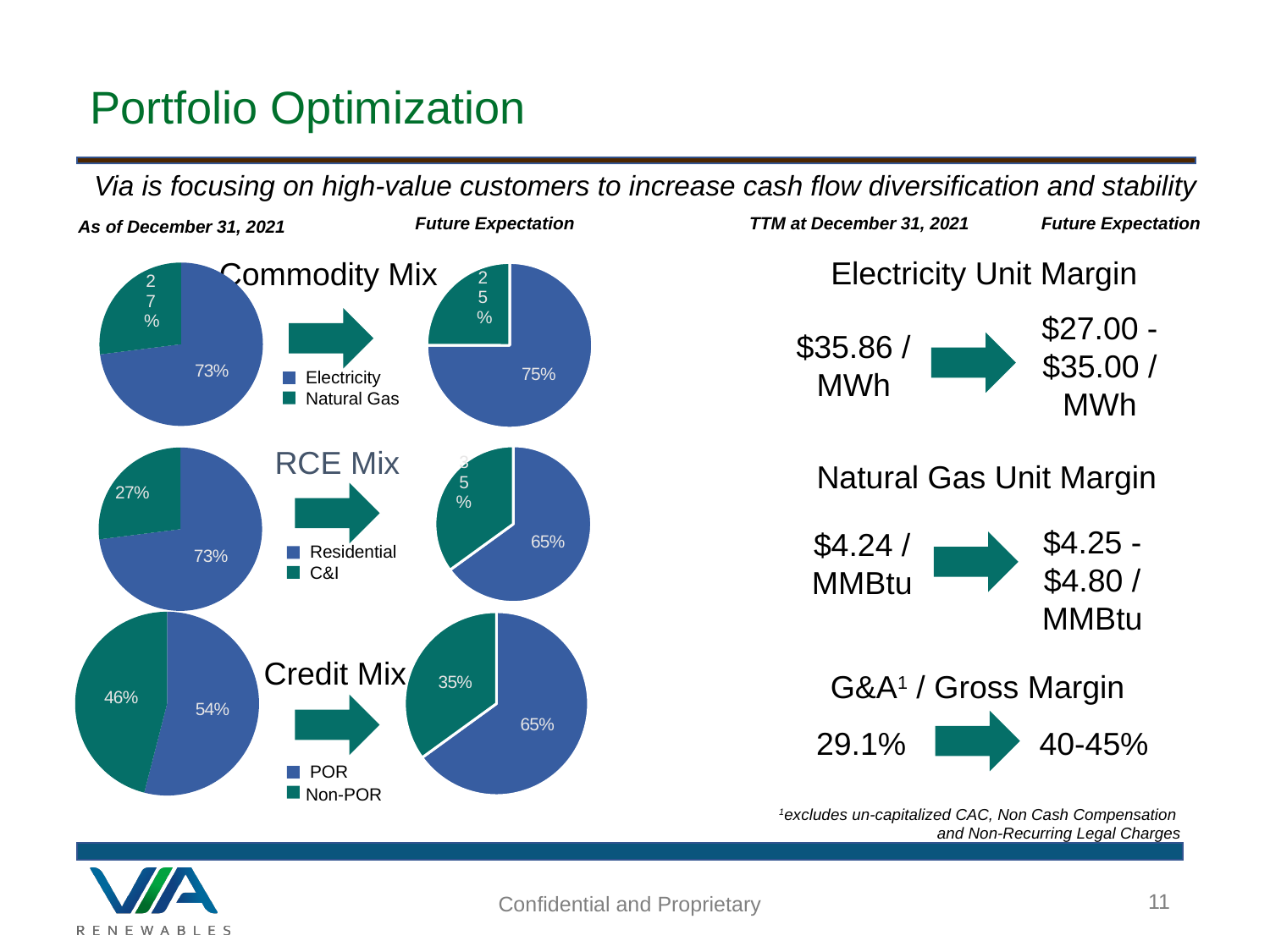
In the Commodity Mix pie chart as of December 31, 2021, what share is Electricity? 73% In the Credit Mix pie chart as of December 31, 2021, what share is Non-POR? 46% In the Credit Mix pie chart as of December 31, 2021, which slice is larger, POR or Non-POR? POR How many entries does the legend of the RCE Mix chart list? 2 In the Future Expectation Commodity Mix pie chart, what share is Electricity? 75% In the RCE Mix pie chart as of December 31, 2021, what share is C&I? 27% In the Credit Mix pie chart as of December 31, 2021, what is the difference between the POR and Non-POR shares? 8% In the Future Expectation RCE Mix pie chart, what share is Residential? 65% In the Future Expectation Credit Mix pie chart, what share is Non-POR? 35% In the Commodity Mix pie chart as of December 31, 2021, what share is Natural Gas? 27% What kind of chart is used to show the Commodity Mix? Pie chart In the Credit Mix pie chart as of December 31, 2021, what share is POR? 54%